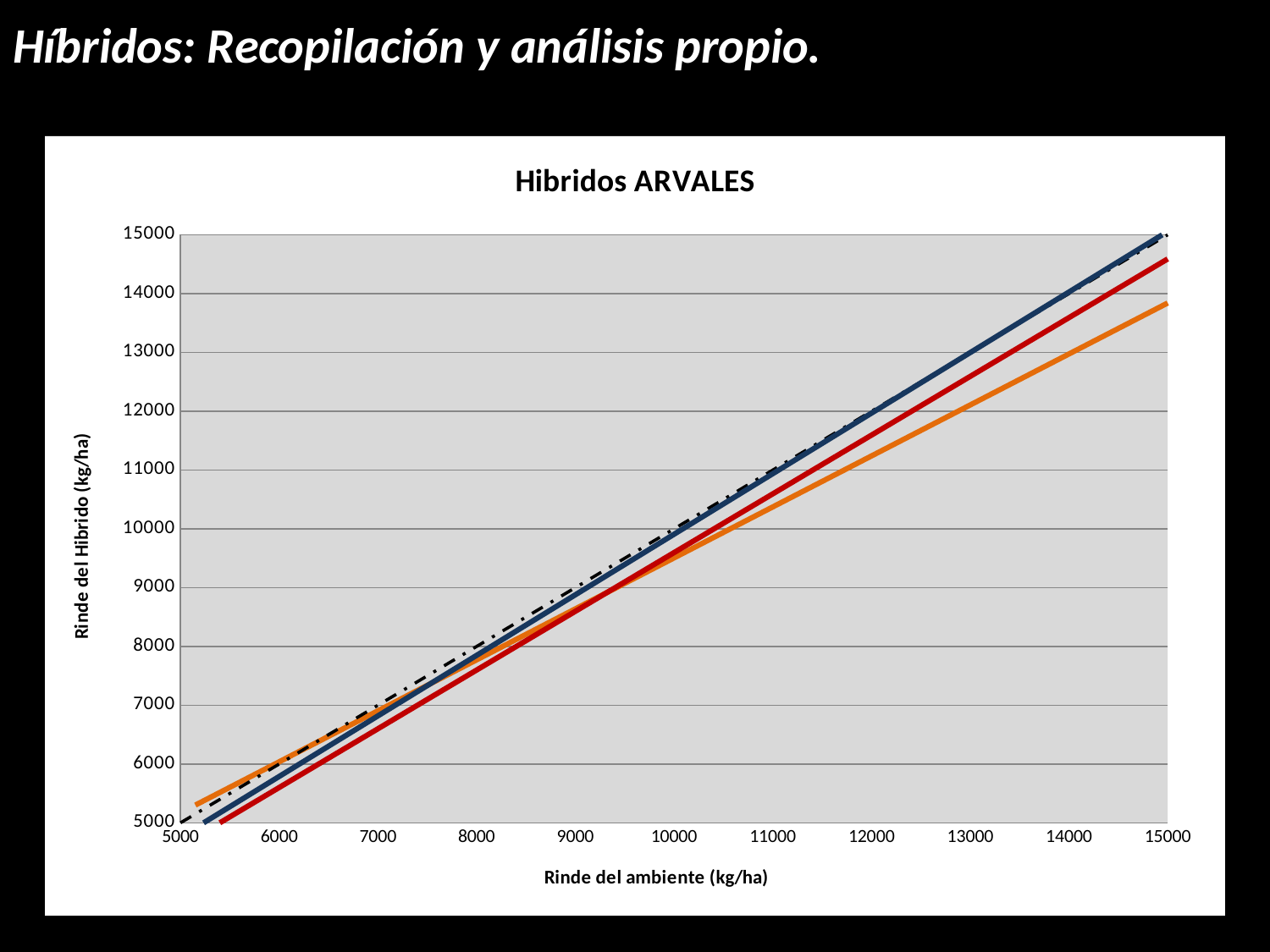
At an x value of 15000, is the orange line greater or less than 14000? less What is the label of the x axis? Rinde del ambiente (kg/ha) At an x value of 15000, which line is higher, the blue line or the orange line? the blue line Do the plotted lines rise or fall as the x-axis value increases? rise How many lines are plotted on the chart? 4 What is the highest value shown on the y axis? 15000 At an x value of 6000, is the orange line greater or less than 7000? less What is the title of the chart? Hibridos ARVALES At an x value of 15000, is the red line greater or less than 14000? greater What kind of chart is shown on the slide? line chart